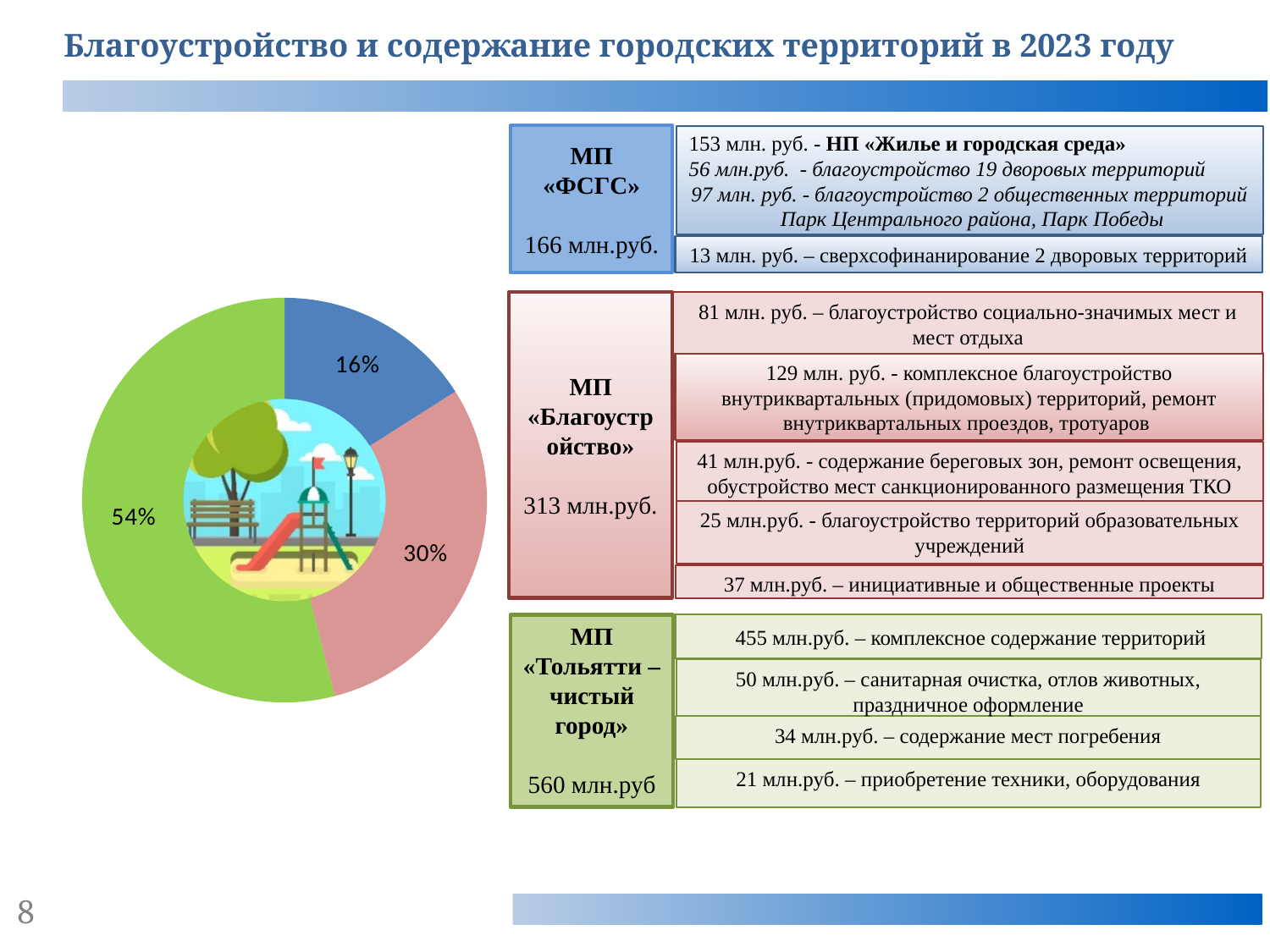
Is the share of the green slice in the pie chart greater or less than 50%? greater By how many percentage points does the green slice exceed the blue slice in the pie chart? 38 What is the smallest share shown in the pie chart? 16% What is the largest share shown in the pie chart? 54% Which slice of the pie chart is larger, the blue one or the pink one? the pink one By how many percentage points does the green slice exceed the pink slice in the pie chart? 24 What percentage is labelled on the pink slice of the pie chart? 30% How many slices does the pie chart have? 3 What kind of chart is shown on the left of the slide? doughnut chart What percentage is labelled on the blue slice of the pie chart? 16% What colour is the largest slice of the pie chart? green What percentage is labelled on the green slice of the pie chart? 54%